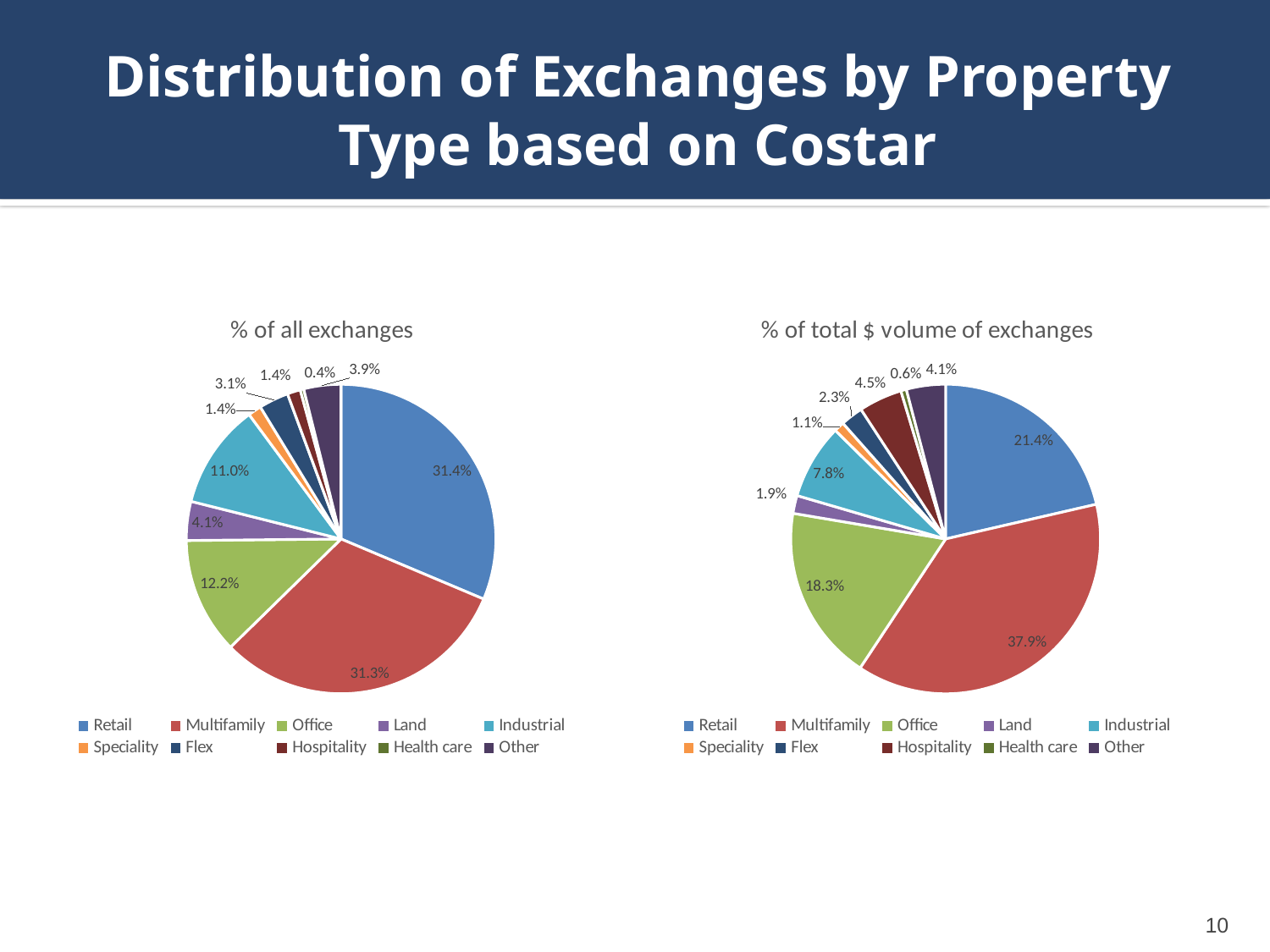
In the '% of total $ volume of exchanges' pie chart, what is the difference in percentage points between Multifamily and Retail? 16.5 How many property types does the legend of the '% of all exchanges' pie chart list? 10 What is the title of the chart on the left of the slide? % of all exchanges In the '% of all exchanges' pie chart, which property type has the smallest share? Health care In the '% of all exchanges' pie chart, what share does Office have? 12.2% In the '% of total $ volume of exchanges' pie chart, what share does Multifamily have? 37.9% In the '% of total $ volume of exchanges' pie chart, what share does Industrial have? 7.8% In the '% of all exchanges' pie chart, which is larger, Office or Land? Office In the '% of total $ volume of exchanges' pie chart, which is larger, Retail or Office? Retail What type of chart is used for '% of total $ volume of exchanges'? Pie chart In the '% of total $ volume of exchanges' pie chart, which property type has the largest share? Multifamily In the '% of all exchanges' pie chart, what share does Industrial have? 11.0%